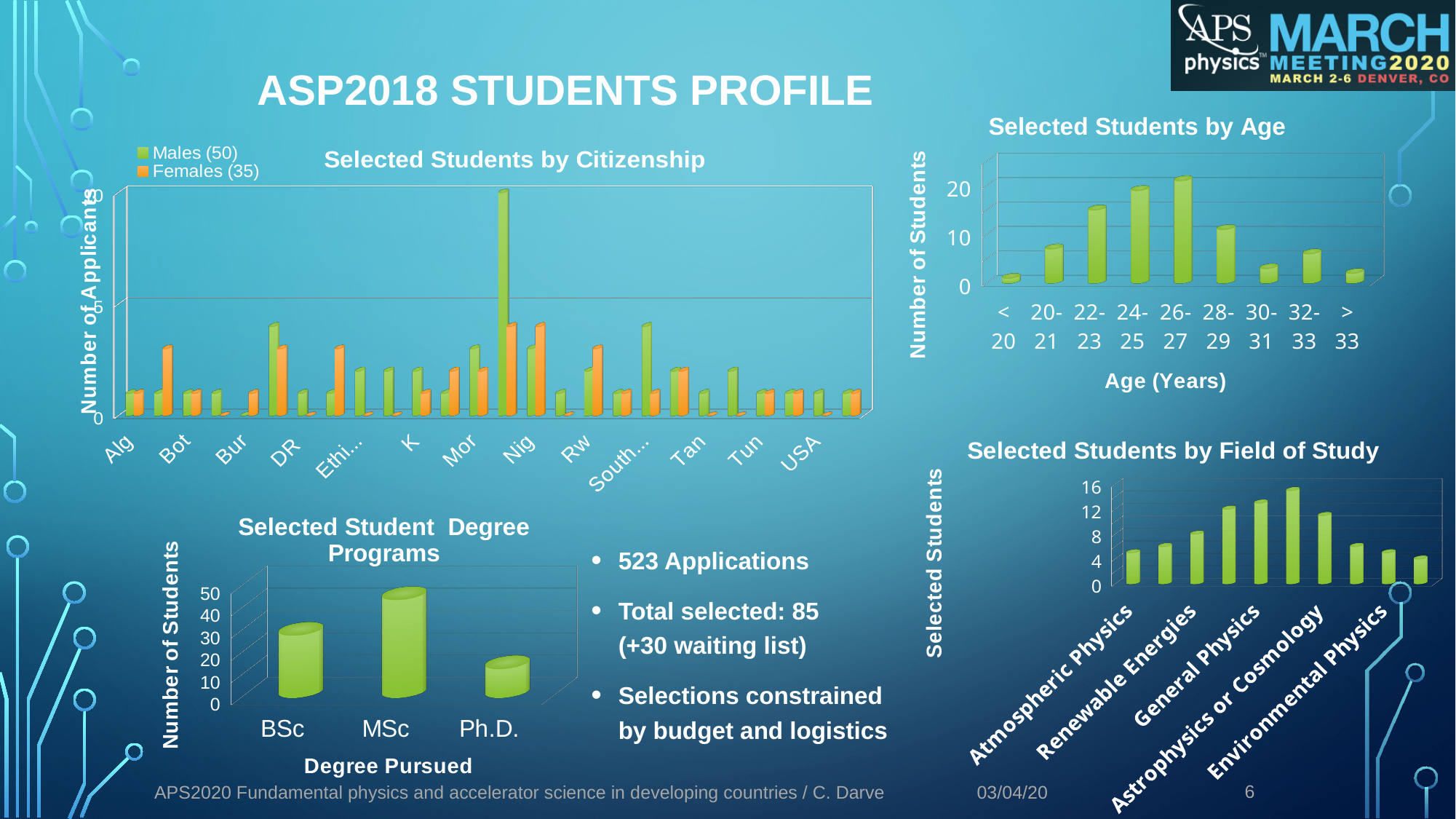
How many age groups are shown in the 'Selected Students by Age' chart? 9 In the 'Selected Students by Field of Study' chart, is the value for Atmospheric Physics greater or less than 8? less In the 'Selected Student Degree Programs' chart, is the value for BSc greater or less than 20? greater In the 'Selected Student Degree Programs' chart, which degree has the highest number of students? MSc In the 'Selected Student Degree Programs' chart, which degree has the lowest number of students? Ph.D. In the 'Selected Students by Age' chart, is the value for the 22-23 age group greater or less than 10? greater In the 'Selected Students by Age' chart, which age group has the lowest number of students? < 20 In the 'Selected Students by Age' chart, which age group has the highest number of students? 26-27 How many degree categories are shown in the 'Selected Student Degree Programs' chart? 3 What kind of chart is the 'Selected Student Degree Programs' chart? bar chart How many series does the legend of the 'Selected Students by Citizenship' chart list? 2